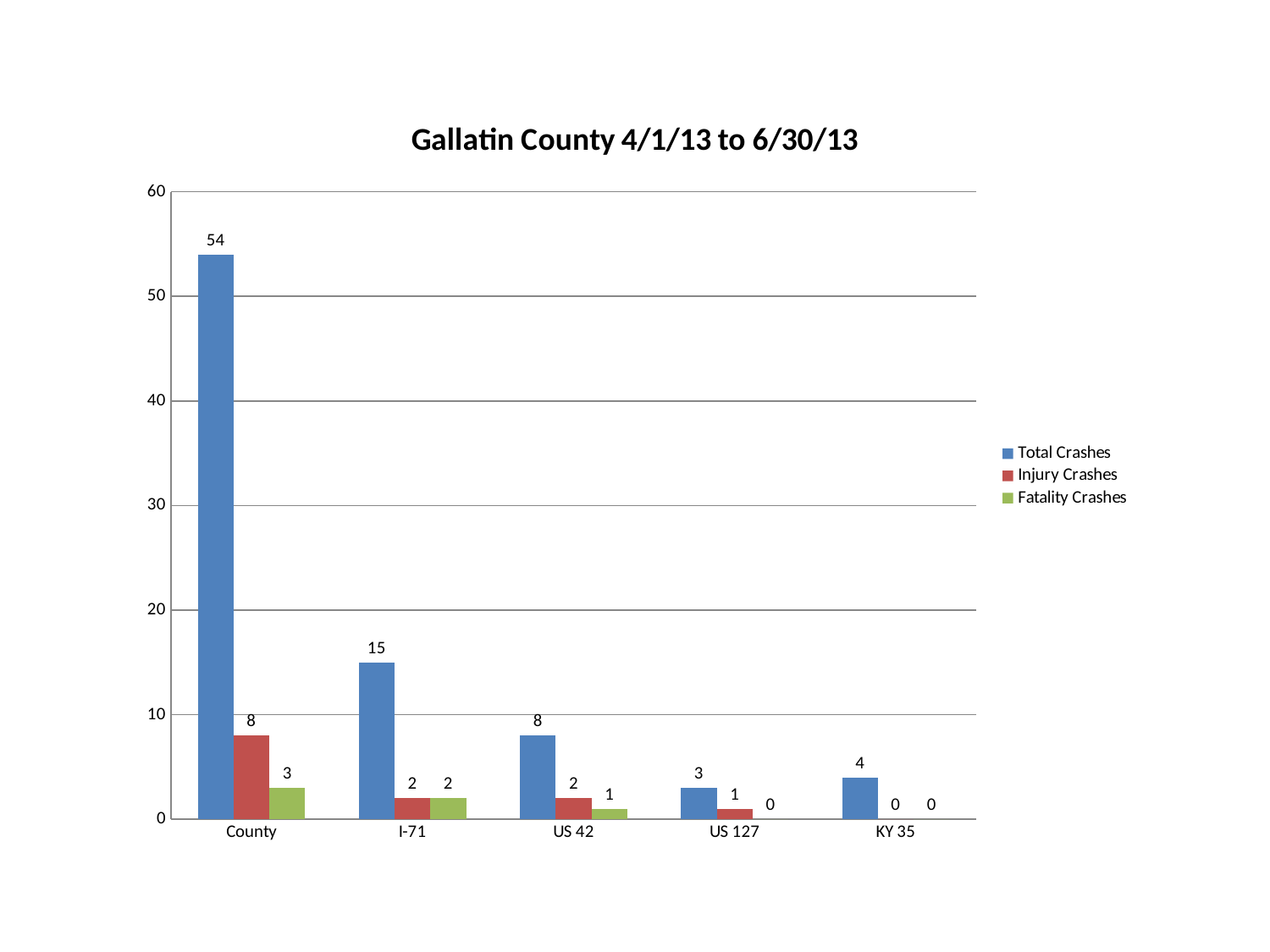
How many series does the legend list? 3 Is the value of Total Crashes for County greater or less than 50? greater Which category has the lowest Total Crashes? US 127 What is the value of Total Crashes for KY 35? 4 What is the value of Injury Crashes for I-71? 2 What type of chart is shown on the slide? Bar chart How many categories are shown on the x axis? 5 What is the difference between Total Crashes for I-71 and Total Crashes for US 42? 7 Which category has the highest Total Crashes? County Which is larger: Injury Crashes for County or Injury Crashes for US 127? Injury Crashes for County What is the value of Fatality Crashes for US 42? 1 What is the value of Total Crashes for County? 54